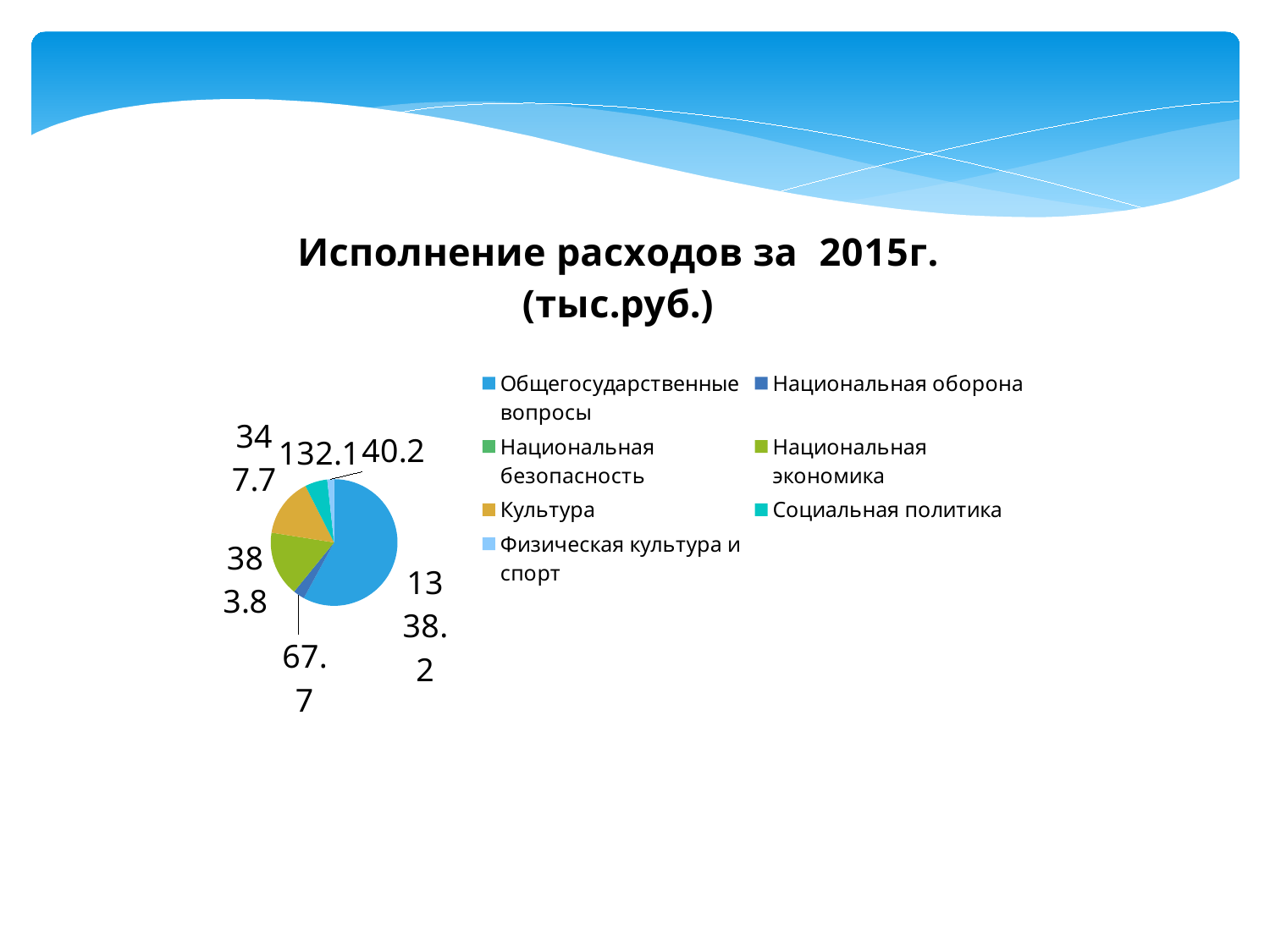
What colour is the slice for Общегосударственные вопросы? blue What is the difference between the values for Общегосударственные вопросы and Культура? 990.5 What is the title of the chart? Исполнение расходов за 2015г. (тыс.руб.) Which is larger, the value for Культура or the value for Социальная политика? Культура What is the value for Культура? 347.7 What is the value for Физическая культура и спорт? 40.2 How many entries does the chart legend list? 7 Which category has the largest slice of the pie? Общегосударственные вопросы What is the value for Социальная политика? 132.1 What is the value for Национальная оборона? 67.7 What kind of chart is shown on the slide? pie chart What is the value for Общегосударственные вопросы? 1338.2